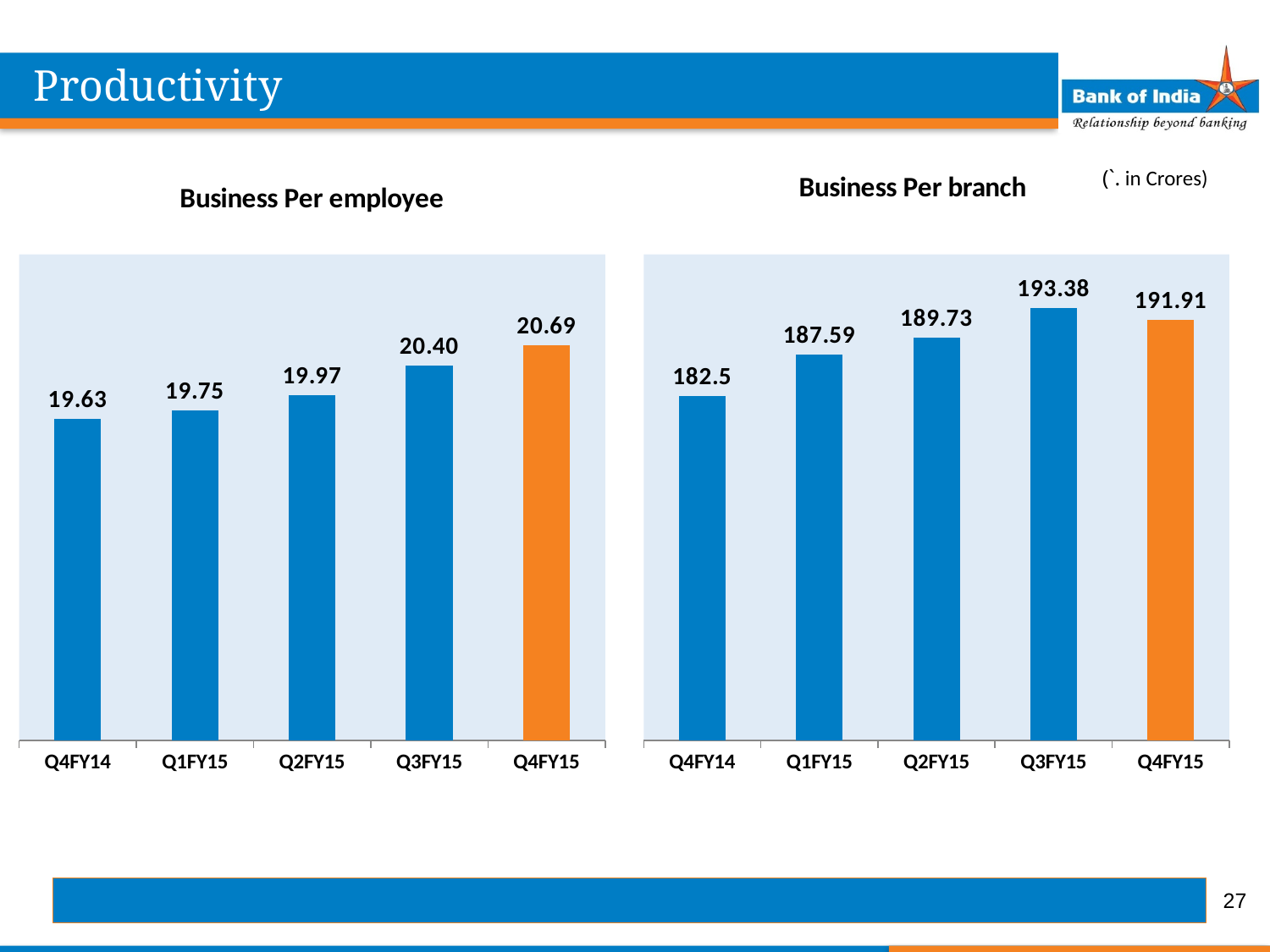
In the Business Per branch chart, which quarter has the highest value? Q3FY15 In the Business Per branch chart, what is the value for Q4FY14? 182.5 What kind of chart is the Business Per branch chart? Bar chart In the Business Per employee chart, which bar is coloured orange? Q4FY15 In the Business Per employee chart, do the values rise or fall from Q4FY14 to Q4FY15? Rise In the Business Per employee chart, what is the difference between Q4FY15 and Q4FY14? 1.06 In the Business Per employee chart, which quarter has the lowest value? Q4FY14 In the Business Per branch chart, what is the value for Q1FY15? 187.59 In the Business Per branch chart, which is larger, Q3FY15 or Q4FY15? Q3FY15 How many quarters are shown in the Business Per employee chart? 5 In the Business Per employee chart, what is the value for Q4FY15? 20.69 In the Business Per branch chart, what is the difference between Q3FY15 and Q2FY15? 3.65